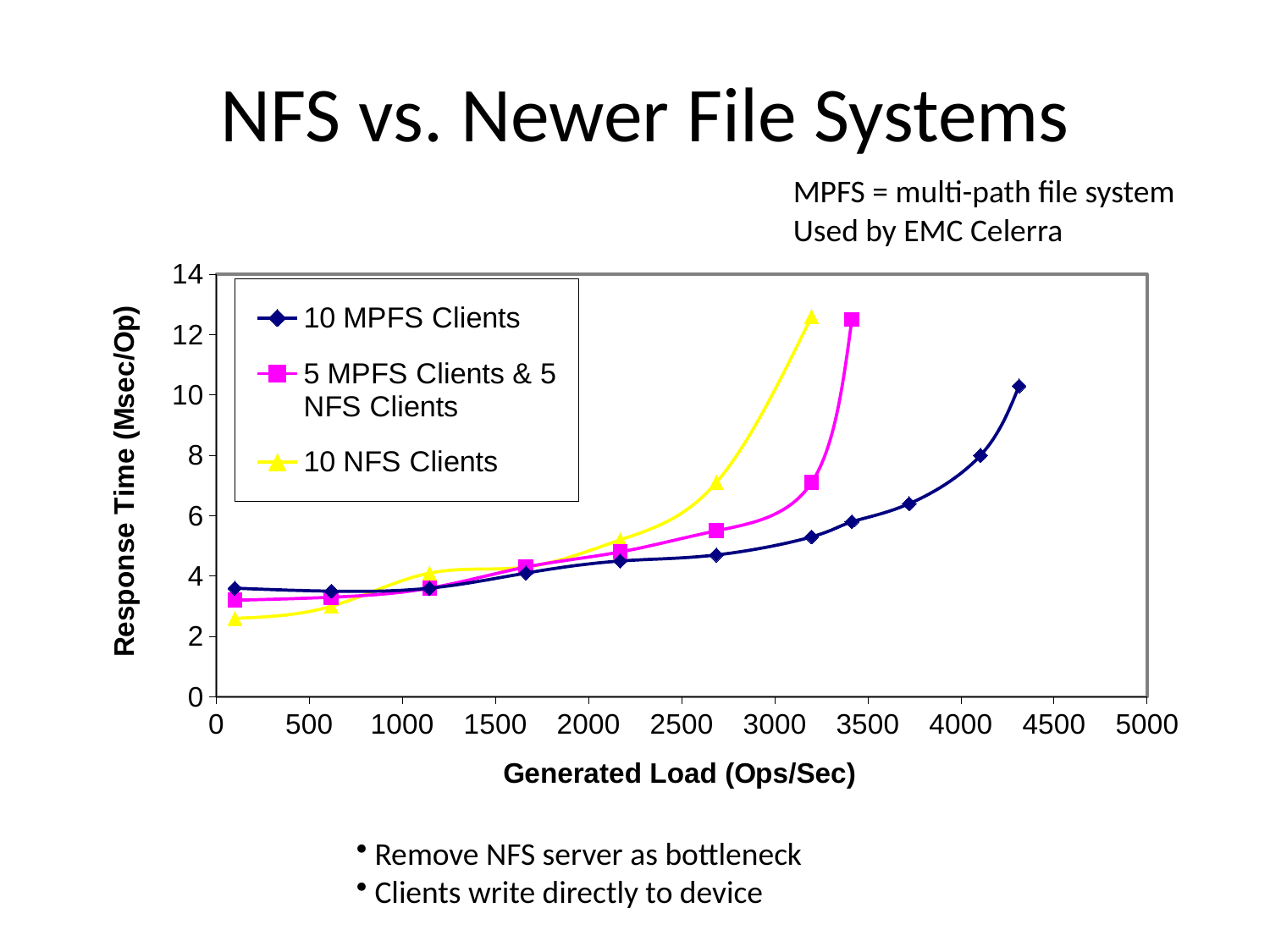
Is the highest response time reached by 5 MPFS Clients & 5 NFS Clients greater or less than 10 Msec/Op? greater Is the response time for 10 MPFS Clients at a generated load of about 3200 Ops/Sec greater or less than 6 Msec/Op? less Is the highest response time reached by 10 NFS Clients greater or less than 12 Msec/Op? greater Does the response time for 10 NFS Clients rise or fall as the generated load increases? rise What kind of chart is shown on the slide? line chart What is the label of the x axis? Generated Load (Ops/Sec) Which series reaches the highest generated load on the x axis? 10 MPFS Clients What is the label of the y axis? Response Time (Msec/Op) At a generated load of about 2700 Ops/Sec, which series has the higher response time: 10 NFS Clients or 10 MPFS Clients? 10 NFS Clients How many data points are plotted for the 10 NFS Clients series? 7 How many series does the legend list? 3 Which series has the lowest response time at the lowest generated load (around 100 Ops/Sec)? 10 NFS Clients